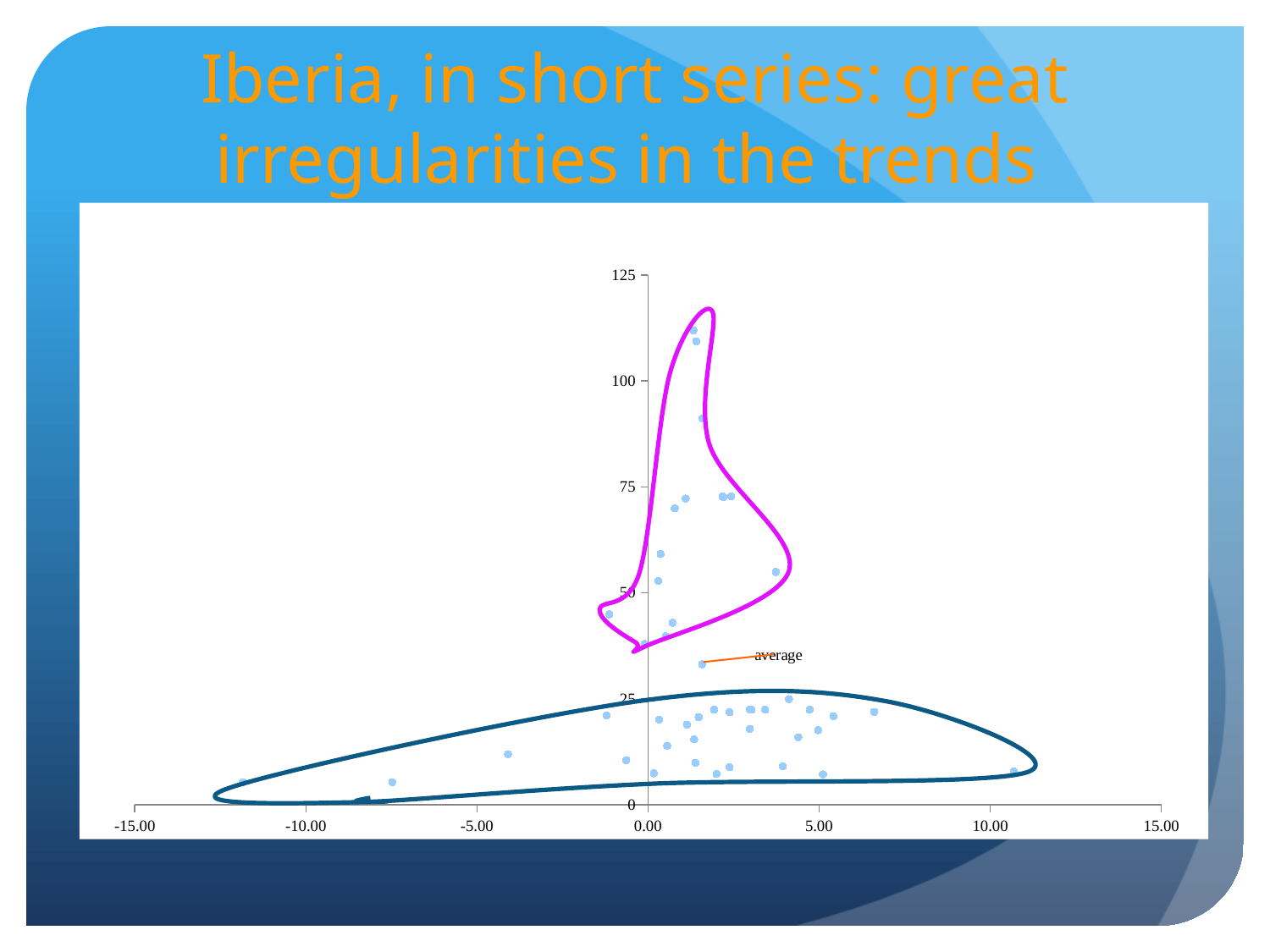
Is the y value of the highest point on the chart greater or less than 100? greater Is the x value of the point labelled "average" greater or less than 0.00? greater Is the y value of the point labelled "average" greater or less than 50? less What kind of chart is shown on the slide? scatter chart What text label is attached to one of the points with an arrow? average What is the highest tick value shown on the y axis? 125